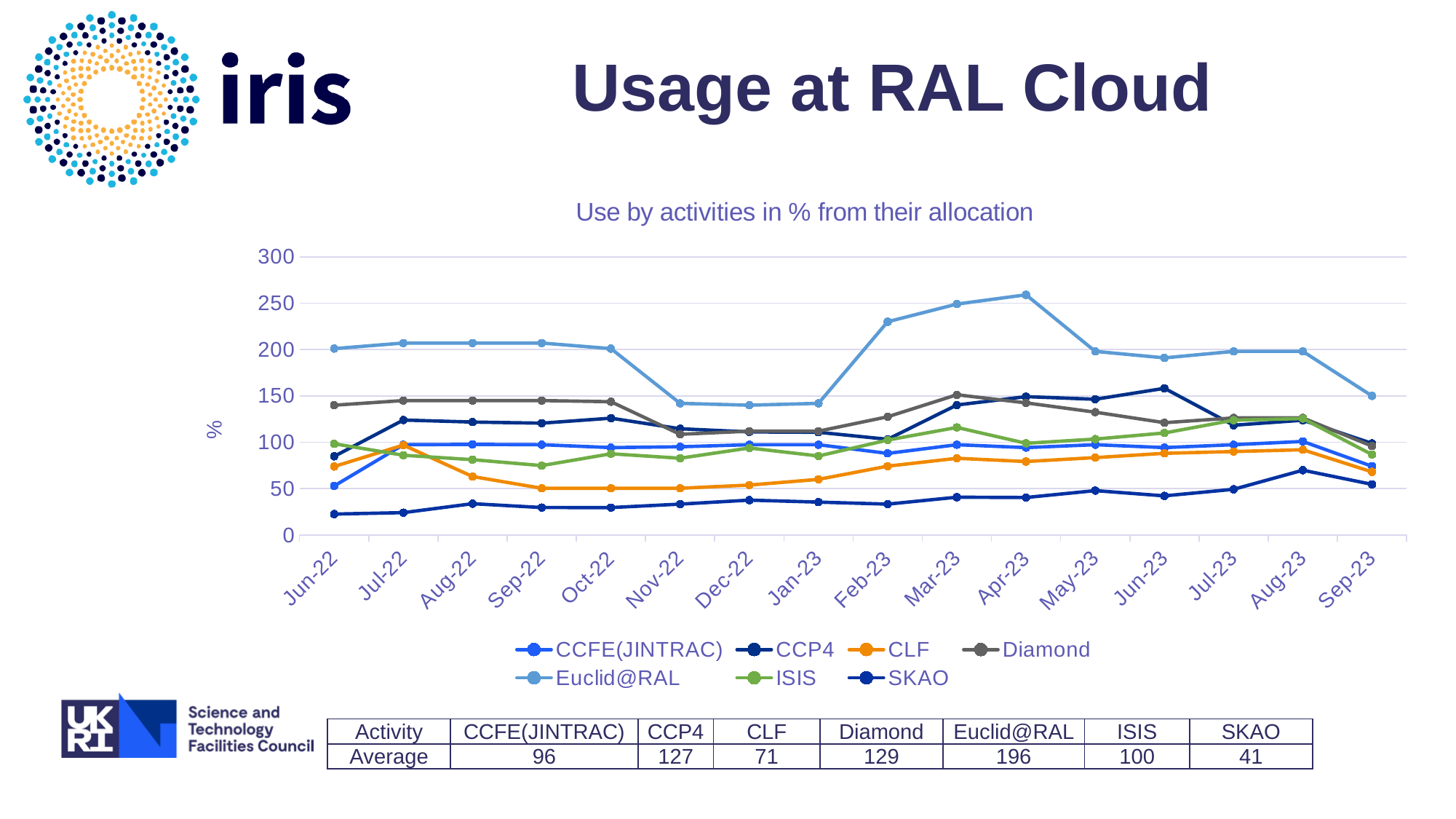
Is the value for Euclid@RAL in Nov-22 greater or less than 150? less What kind of chart is shown on the slide? line chart Is the value for SKAO in Jun-22 greater or less than 50? less Is the value for Euclid@RAL in Apr-23 greater or less than 250? greater How many months are plotted along the x axis? 16 How many series does the chart legend list? 7 What is the subtitle shown above the chart? Use by activities in % from their allocation Which series has the lowest value in Jun-22? SKAO In Mar-23, which is larger: the value for Euclid@RAL or the value for SKAO? Euclid@RAL Which series has the highest value in Apr-23? Euclid@RAL Does the Euclid@RAL line rise or fall from Apr-23 to Sep-23? fall